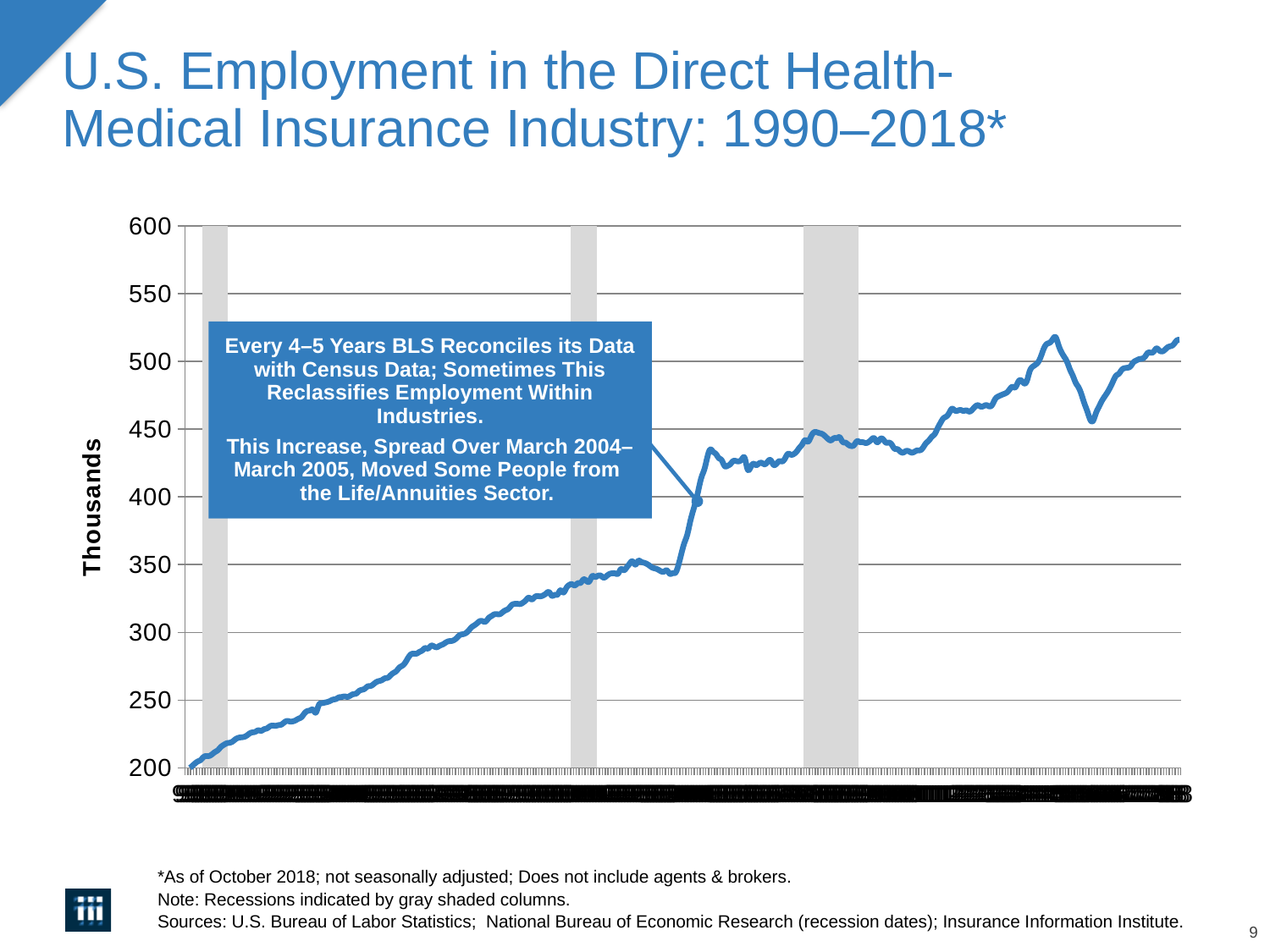
Is the lowest point on the line greater or less than 250? less What is the label on the vertical axis? Thousands Is the highest point on the line greater or less than 500? greater Is the value at the start of the series (1990) greater or less than 250? less Which is larger, the value at the start of the series (1990) or the value at the end of the series (2018)? the end of the series (2018) What is the highest value shown on the vertical axis? 600 Do the values generally rise or fall from the start of the series (1990) to the end (2018)? rise What kind of chart is shown on the slide? line chart What do the gray shaded columns on the chart indicate? Recessions